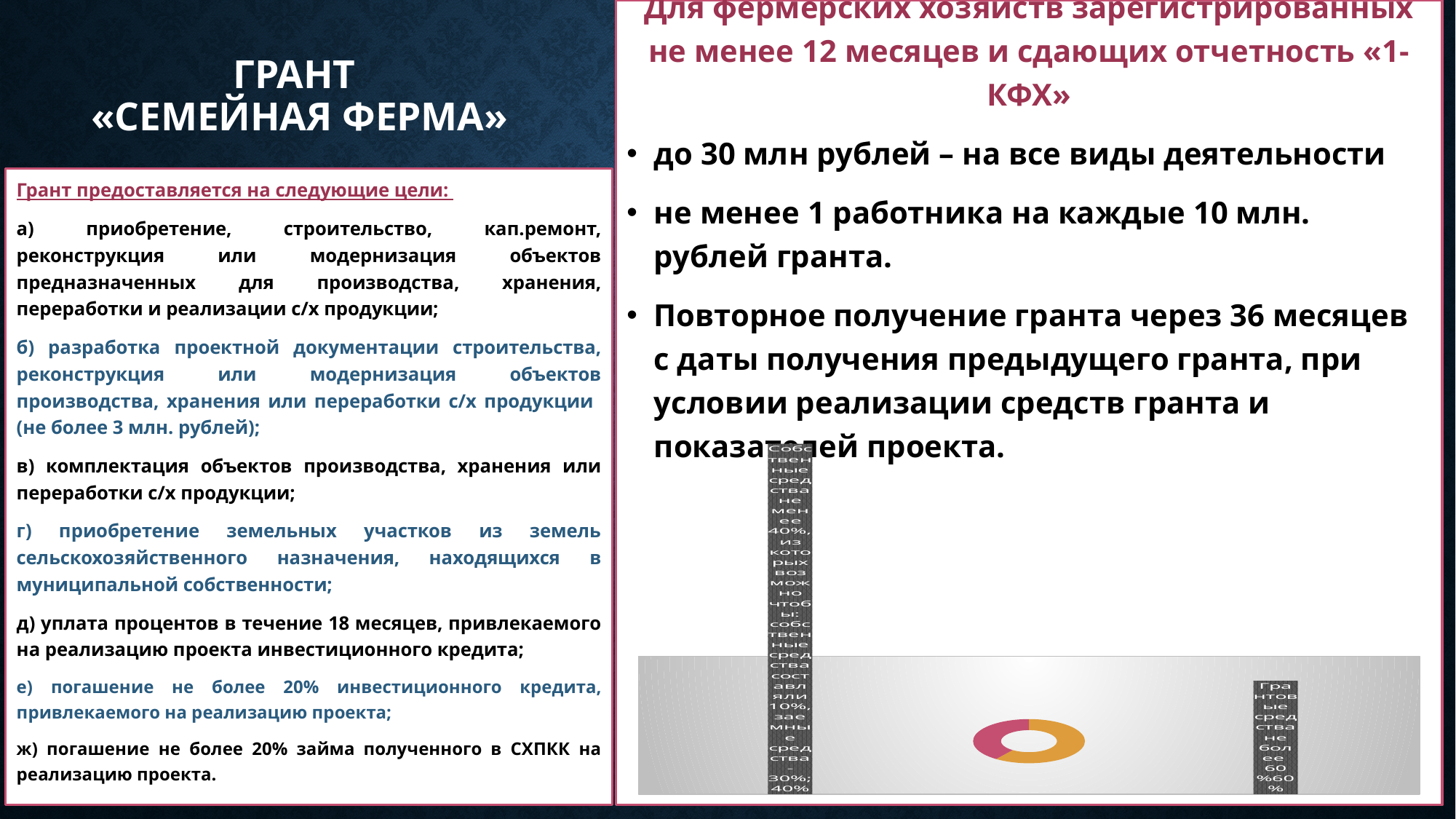
Which colour is the larger slice of the doughnut chart? orange According to the doughnut chart label, what is the maximum share of grant funds? не более 60% In the doughnut chart, what share is labelled for own funds (Собственные средства)? 40% Which slice of the doughnut chart is the smallest? Собственные средства (40%) What kind of chart is shown at the bottom right of the slide? pie chart (doughnut) According to the doughnut chart label, what is the minimum share of own funds? не менее 40% In the doughnut chart, what share is labelled for grant funds (Грантовые средства)? 60% How many slices does the doughnut chart at the bottom right have? 2 Which slice of the doughnut chart is the largest? Грантовые средства (60%) In the doughnut chart, which is larger: the share of grant funds or the share of own funds? grant funds (Грантовые средства) According to the own-funds label on the doughnut chart, into what two parts can the 40% own funds be split? собственные средства 10%, заемные средства 30% In the doughnut chart, what is the difference between the grant funds share and the own funds share? 20%